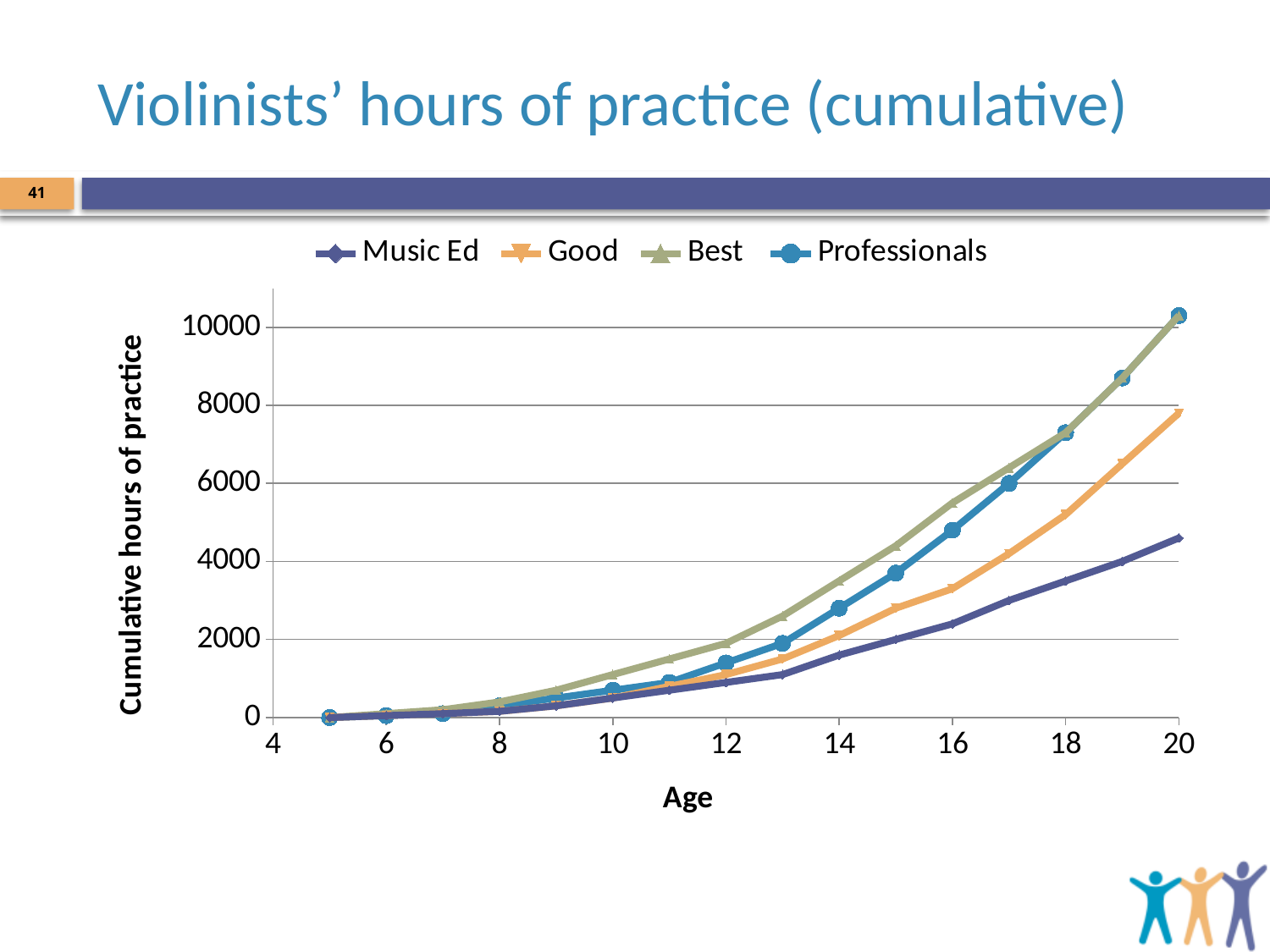
How many series does the legend list? 4 At age 16, which is larger: Best or Professionals? Best Which series has the lowest cumulative hours of practice at age 20? Music Ed What is the title of the chart? Violinists' hours of practice (cumulative) What is the label of the vertical axis? Cumulative hours of practice Is the value for Music Ed at age 20 greater or less than 4000? greater Is the value for Good at age 20 greater or less than 8000? less What kind of chart is shown on the slide? line chart Is the value for Professionals at age 16 greater or less than 4000? greater Do the cumulative hours of practice for the Professionals series rise or fall as age increases? rise At age 20, which is larger: Good or Music Ed? Good